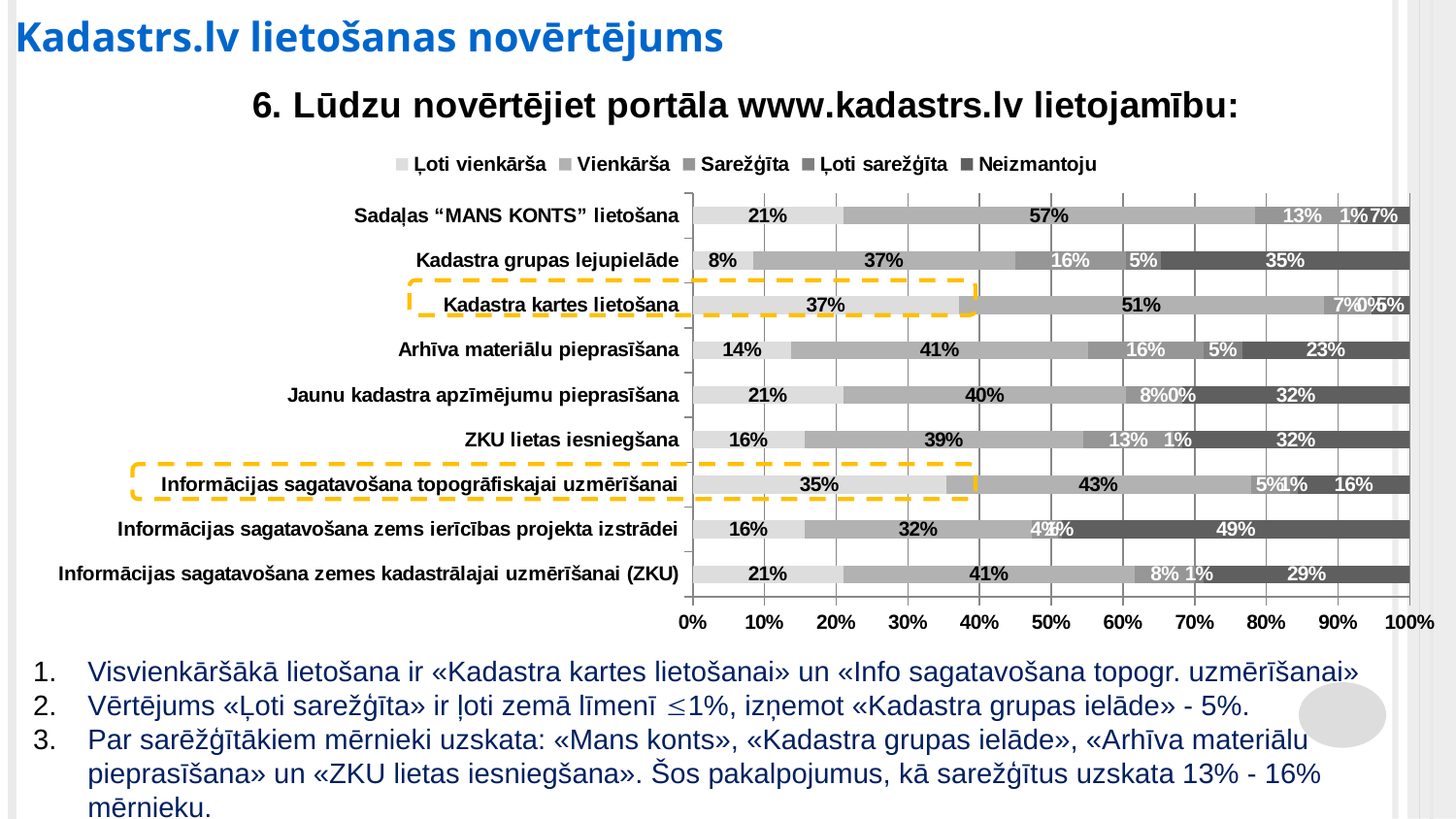
Which category has the lowest "Ļoti vienkārša" value? Kadastra grupas lejupielāde Which category has the highest "Ļoti vienkārša" value? Kadastra kartes lietošana Which is larger: the "Neizmantoju" value for "ZKU lietas iesniegšana" or for "Informācijas sagatavošana topogrāfiskajai uzmērīšanai"? ZKU lietas iesniegšana What is the "Ļoti vienkārša" value for "Kadastra grupas lejupielāde"? 8% What is the "Neizmantoju" value for "Kadastra grupas lejupielāde"? 35% What type of chart is shown on the slide? Stacked bar chart What is the "Ļoti vienkārša" value for "Kadastra kartes lietošana"? 37% What is the "Sarežģīta" value for "Arhīva materiālu pieprasīšana"? 16% How many categories (services) are plotted on the chart? 9 What is the difference between the "Vienkārša" values for "Sadaļas “MANS KONTS” lietošana" and "Kadastra kartes lietošana"? 6% How many series does the legend list? 5 What is the "Vienkārša" value for "Sadaļas “MANS KONTS” lietošana"? 57%